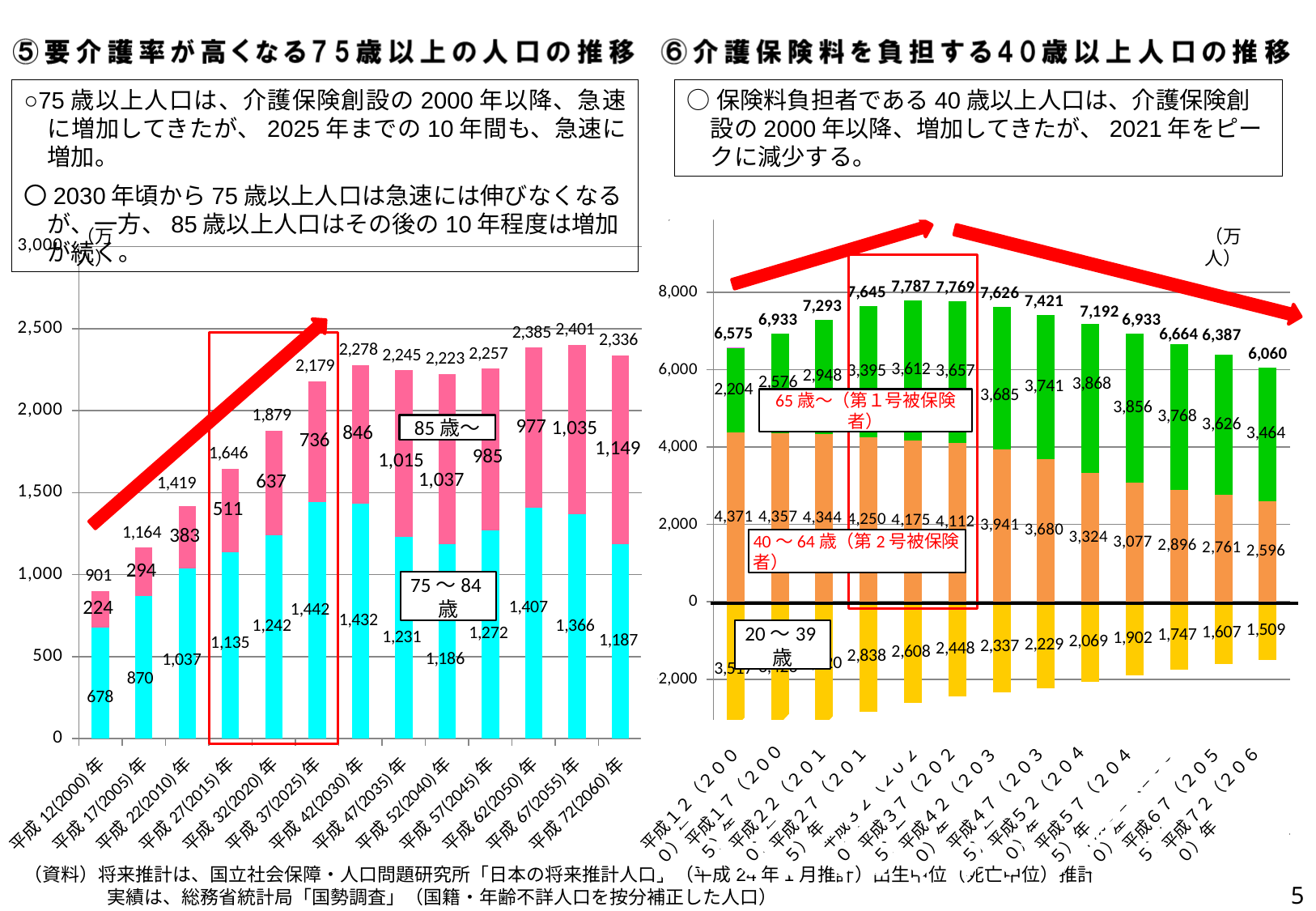
In the left chart (⑤ 75歳以上の人口の推移), how many years are shown on the x axis? 13 In the right chart (⑥ 40歳以上人口の推移), how many age-group series are plotted? 3 In the right chart (⑥ 40歳以上人口の推移), what is the 40～64歳 value for 平成72(2060)年? 2,596 In the right chart (⑥ 40歳以上人口の推移), what is the 65歳～ value for 平成12(2000)年? 2,204 In the left chart (⑤ 75歳以上の人口の推移), what is the total population labeled for 平成37(2025)年? 2,179 In the left chart (⑤ 75歳以上の人口の推移), what is the difference between the 85歳～ values for 平成37(2025)年 and 平成32(2020)年? 99 In the right chart (⑥ 40歳以上人口の推移), what is the highest total value labeled above the bars? 7,787 In the left chart (⑤ 75歳以上の人口の推移), which year has the highest total? 平成67(2055)年 In the left chart (⑤ 75歳以上の人口の推移), what kind of chart is used? Stacked bar chart In the left chart (⑤ 75歳以上の人口の推移), what is the 75～84歳 value for 平成12(2000)年? 678 In the right chart (⑥ 40歳以上人口の推移), do the 40～64歳 values rise or fall from 2000 to 2060? Fall In the left chart (⑤ 75歳以上の人口の推移), what is the 85歳～ value for 平成72(2060)年? 1,149